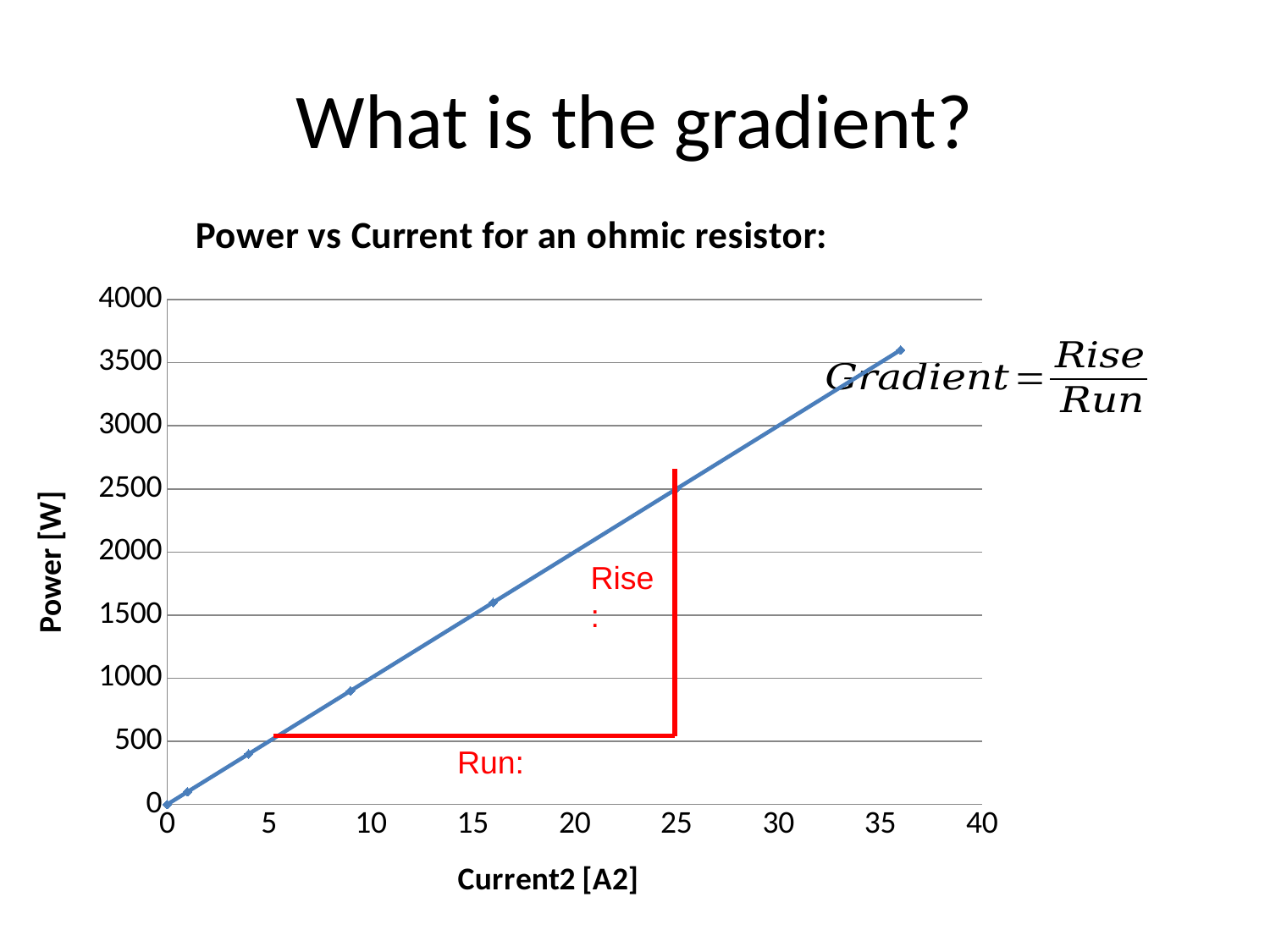
What is the label on the vertical axis of the chart? Power [W] Does the plotted power rise or fall as the value on the x axis increases? rise What is the title of the chart? Power vs Current for an ohmic resistor: Is the power value of the data point at x = 9 greater or less than 1000? less What kind of chart is shown on the slide? line chart Which of the two plotted points has the larger power value, the one at x = 16 or the one at x = 25? x = 25 Is the power value of the data point at x = 36 greater or less than 3500? greater What is the power value of the data point at x = 25 on the chart? 2500 Is the power value of the data point at x = 4 greater or less than 500? less How many data points are plotted on the chart? 7 What is the highest value shown on the vertical axis of the chart? 4000